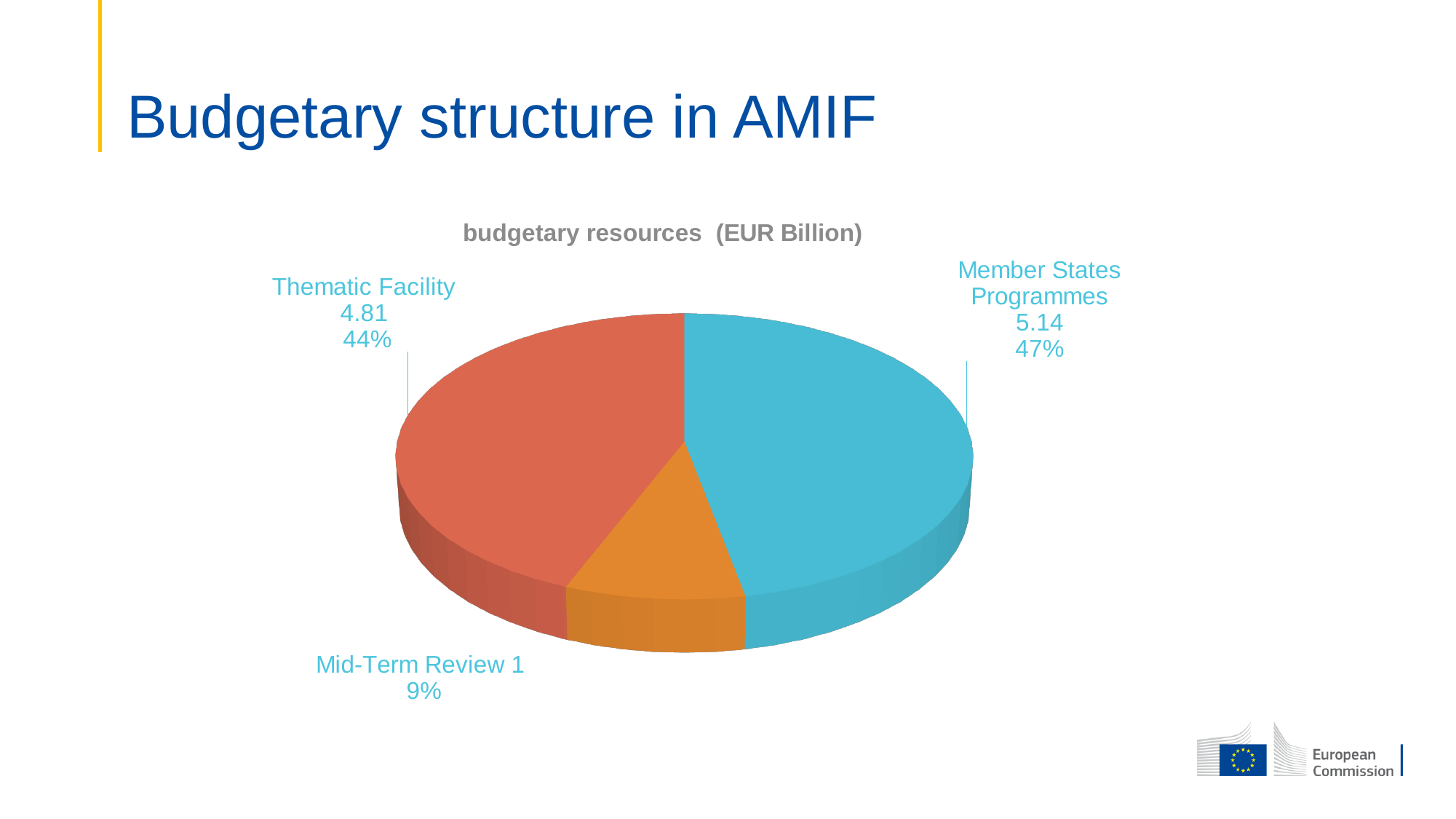
What share of the pie does Mid-Term Review represent? 9% What is the value for Thematic Facility? 4.81 What is the value for Member States Programmes? 5.14 What kind of chart is shown on the slide? pie chart How many slices does the pie chart have? 3 What is the difference between the values for Member States Programmes and Thematic Facility? 0.33 What is the title of the chart? budgetary resources (EUR Billion) Which is larger, the value for Thematic Facility or the value for Member States Programmes? Member States Programmes Which category has the largest slice? Member States Programmes Which category has the smallest slice? Mid-Term Review What share of the pie does Thematic Facility represent? 44% What share of the pie does Member States Programmes represent? 47%